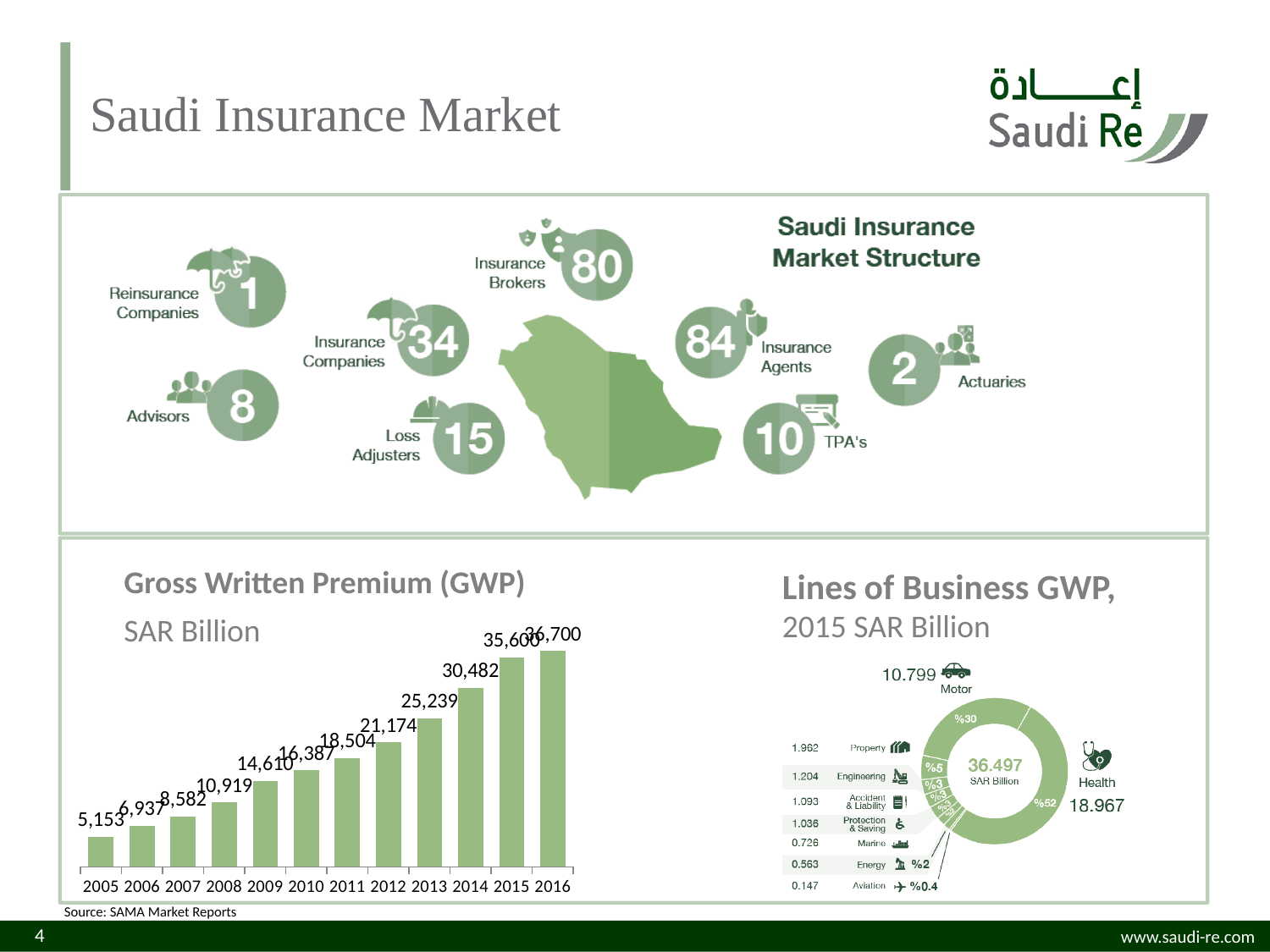
In the Gross Written Premium (GWP) chart, do the values rise or fall from 2005 to 2016? Rise In the Lines of Business GWP, 2015 chart, what is the value for Health? 18.967 In the Gross Written Premium (GWP) chart, which year has the lowest value? 2005 In the Lines of Business GWP, 2015 chart, what share of the total does Motor represent? %30 In the Gross Written Premium (GWP) chart, what is the difference between the 2014 and 2013 values? 5,243 In the Gross Written Premium (GWP) chart, which year has the highest value? 2016 In the Gross Written Premium (GWP) chart, which is larger, the value for 2008 or the value for 2009? 2009 In the Gross Written Premium (GWP) chart, what is the value for 2013? 25,239 What kind of chart is the Gross Written Premium (GWP) chart? Bar chart In the Gross Written Premium (GWP) chart, what is the value for 2010? 16,387 In the Gross Written Premium (GWP) chart, what is the value for 2005? 5,153 How many years are shown in the Gross Written Premium (GWP) bar chart? 12